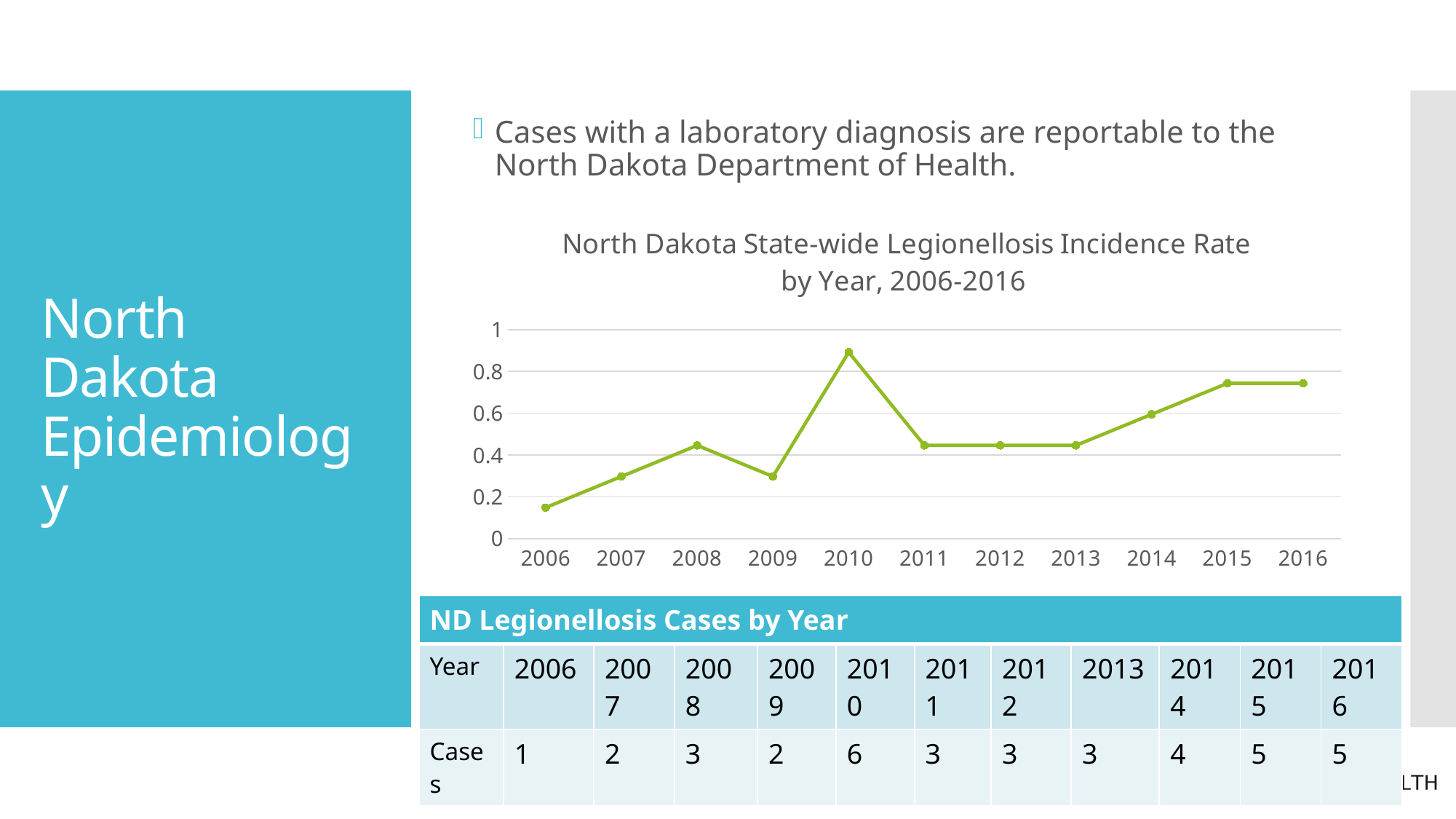
Which year has the lowest incidence rate in the chart? 2006 Is the incidence rate for 2015 greater or less than 0.6? greater Is the incidence rate for 2010 greater or less than 0.8? greater Which year has a higher incidence rate, 2011 or 2015? 2015 What is the title of the chart? North Dakota State-wide Legionellosis Incidence Rate by Year, 2006-2016 What kind of chart is shown on the slide? line chart Is the incidence rate for 2006 greater or less than 0.2? less Which year has a higher incidence rate, 2009 or 2010? 2010 Does the incidence rate rise or fall from 2006 to 2008? rise Which year has the highest incidence rate in the chart? 2010 How many years are plotted on the x axis of the chart? 11